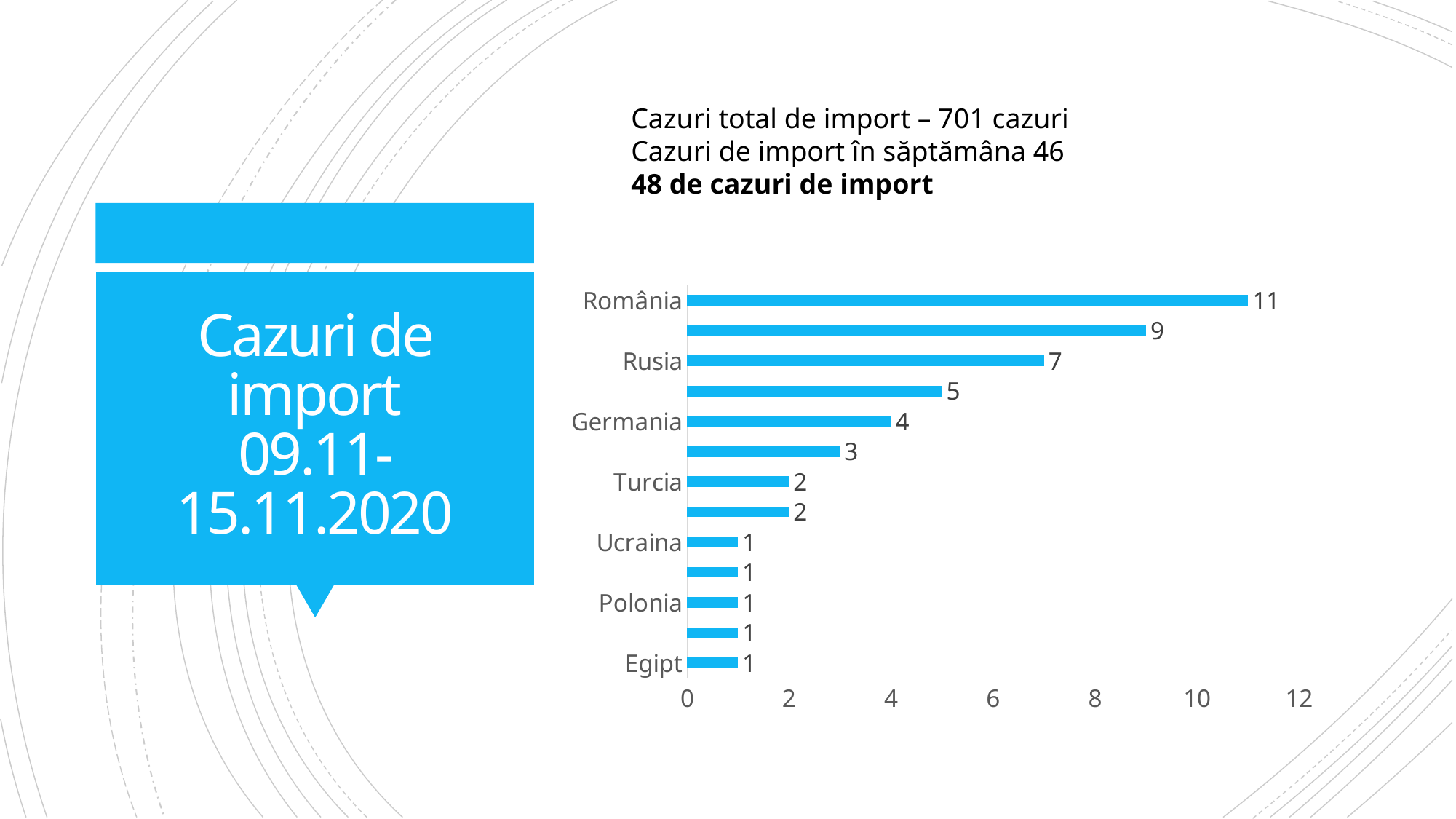
What is the value for România? 11 What is the value for Turcia? 2 What is the value for Egipt? 1 What is the value for Germania? 4 What is the difference between the values for Germania and Turcia? 2 What is the value for Rusia? 7 What kind of chart is shown on the slide? bar chart Which is larger, the value for Rusia or the value for Germania? Rusia Which category has the highest value? România Is the value for România greater or less than 10? greater What is the difference between the values for România and Rusia? 4 How many bars are plotted in the chart? 13